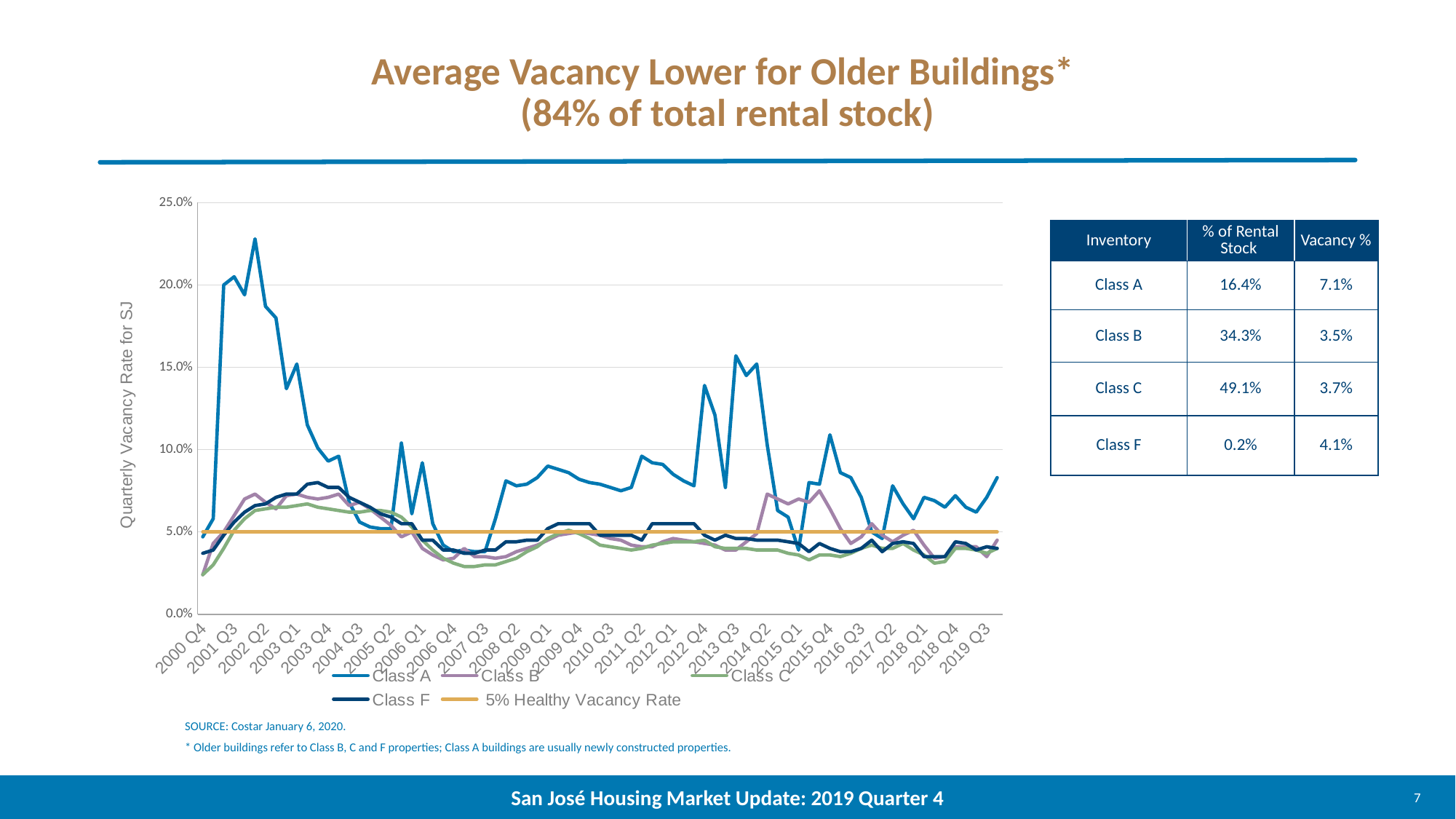
At 2013 Q3, which is larger, the Class A value or the Class B value? Class A Is the value for Class A at 2019 Q3 greater or less than 5.0%? greater What is the title of the chart's y axis? Quarterly Vacancy Rate for SJ What kind of chart is shown on the slide? line chart Does the Class A line rise or fall between 2002 Q2 and 2004 Q3? fall Is the peak value of the Class A line greater or less than 20.0%? greater Is the value for Class C at 2019 Q3 greater or less than 5.0%? less How many series does the chart legend list? 5 Which series reaches the highest vacancy rate anywhere on the chart? Class A What value does the flat horizontal line in the chart represent, according to the legend? 5% Healthy Vacancy Rate What is the highest value shown on the chart's y axis? 25.0%